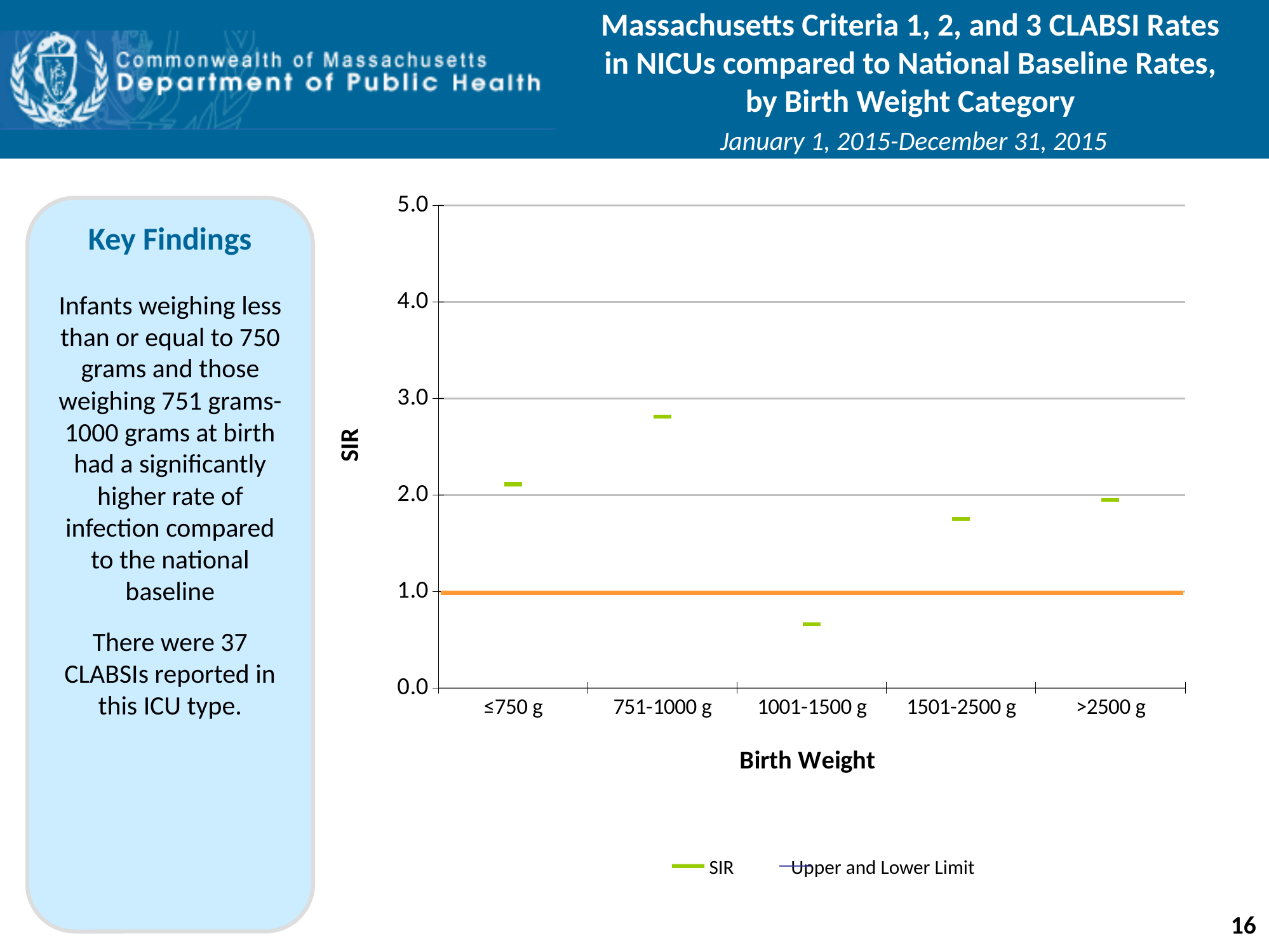
Which birth weight category has the highest SIR? 751-1000 g How many series does the legend list? 2 What is the title of the x axis? Birth Weight Is the SIR for 1501-2500 g greater or less than 2.0? less How many birth weight categories are shown on the x axis? 5 Which birth weight category has the lowest SIR? 1001-1500 g Which has a higher SIR, ≤750 g or 751-1000 g? 751-1000 g Is the SIR for >2500 g greater or less than 1.0? greater Is the SIR for ≤750 g greater or less than 2.0? greater Which has a higher SIR, 1001-1500 g or 1501-2500 g? 1501-2500 g